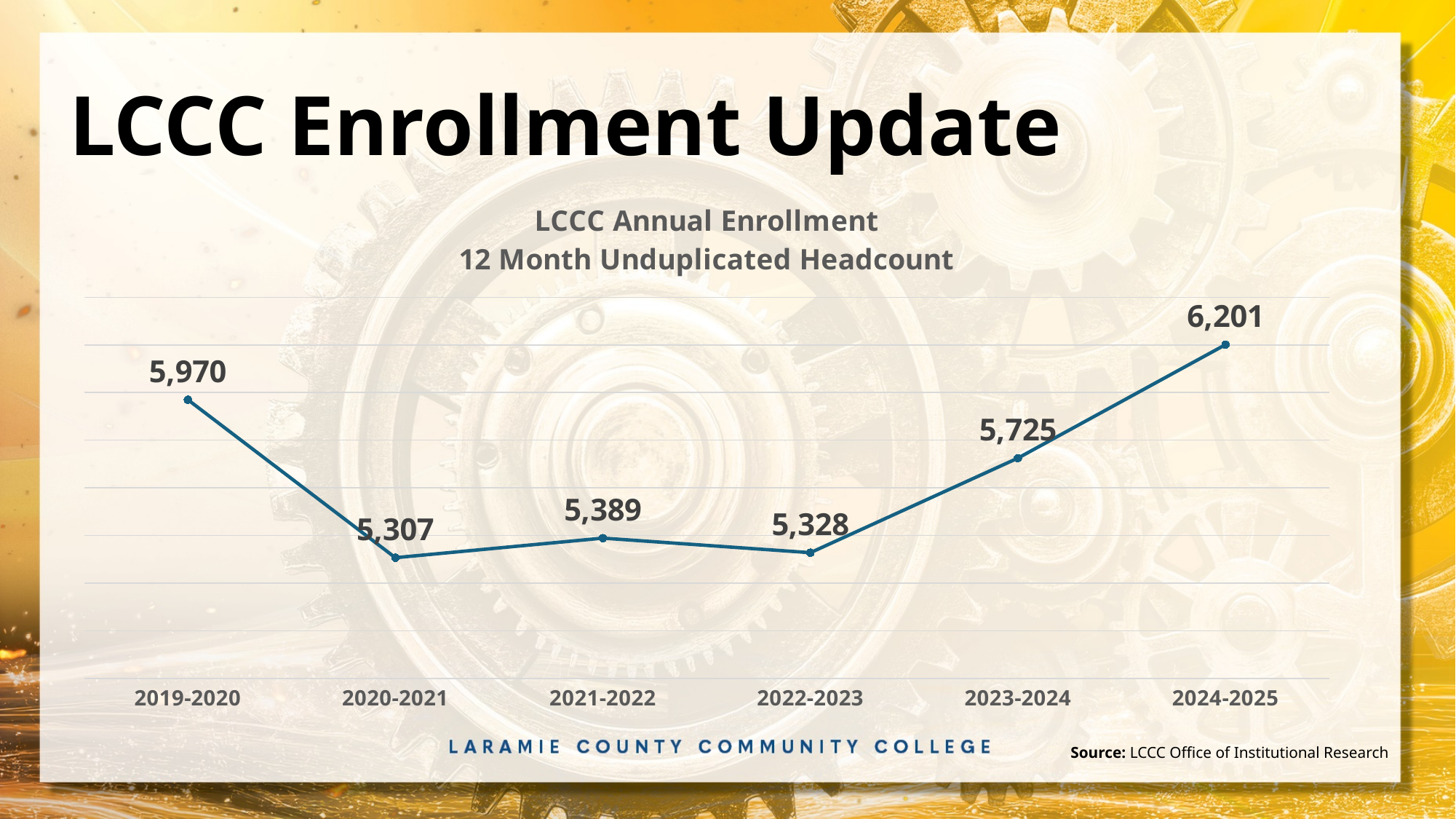
What is the enrollment headcount for 2022-2023? 5,328 What is the difference in enrollment between 2024-2025 and 2023-2024? 476 What is the title of the chart? LCCC Annual Enrollment 12 Month Unduplicated Headcount What is the enrollment headcount for 2024-2025? 6,201 How many academic years are plotted on the chart? 6 Does enrollment rise or fall from 2022-2023 to 2024-2025? Rise What kind of chart is shown on the slide? Line chart Which academic year has the lowest enrollment? 2020-2021 What is the difference in enrollment between 2019-2020 and 2020-2021? 663 Which year has higher enrollment, 2021-2022 or 2022-2023? 2021-2022 What is the enrollment headcount for 2019-2020? 5,970 Which academic year has the highest enrollment? 2024-2025